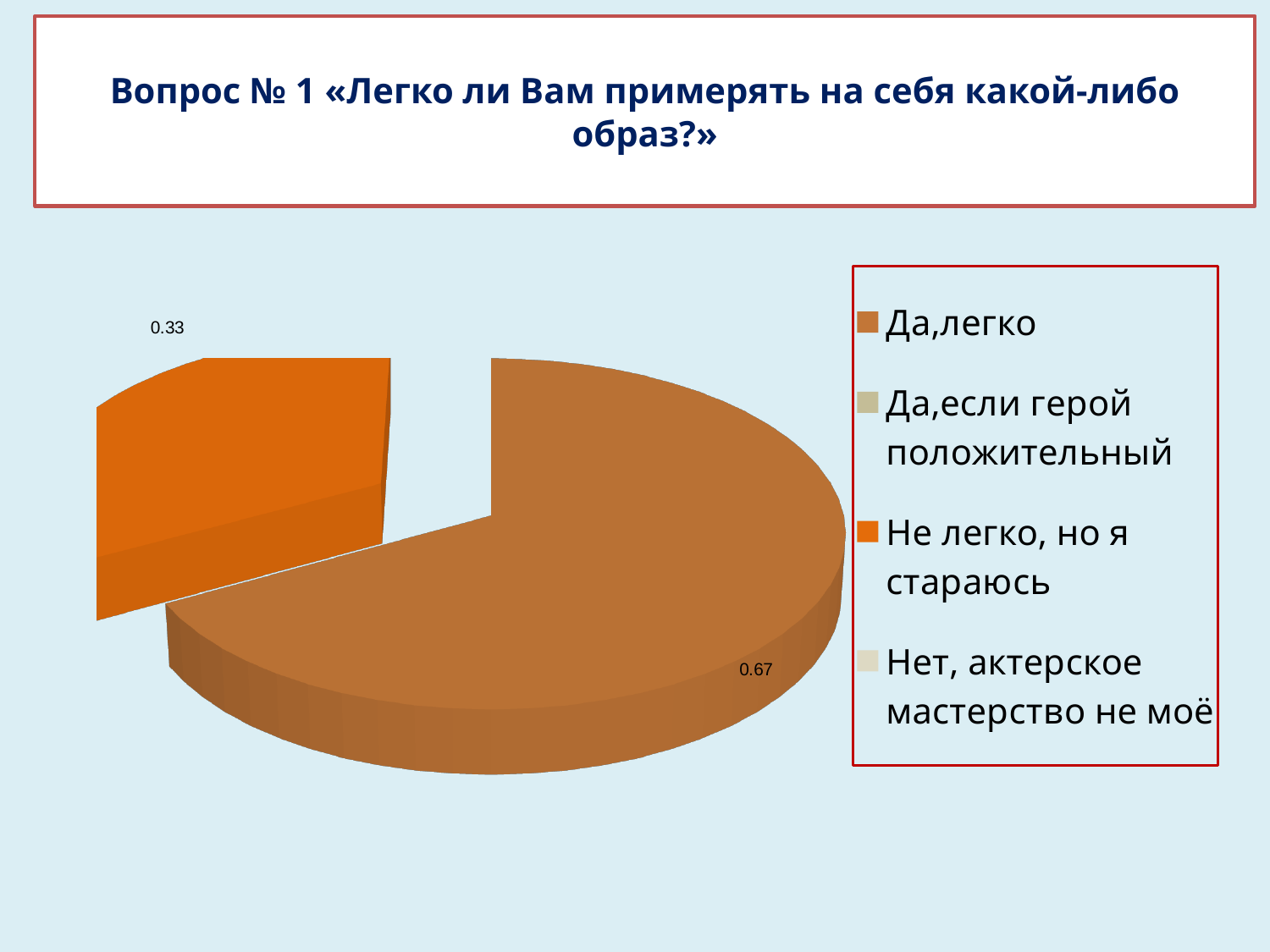
What is the difference between the values for "Да,легко" and "Не легко, но я стараюсь"? 0.34 Which of the two labelled slices is smaller? Не легко, но я стараюсь What is the title of the slide containing the chart? Вопрос № 1 «Легко ли Вам примерять на себя какой-либо образ?» How many entries does the legend list? 4 How many slices with data labels are visible in the pie? 2 Which category has the largest slice of the pie? Да,легко What is the value for "Не легко, но я стараюсь"? 0.33 What kind of chart is shown on the slide? pie chart What is the value for "Да,легко"? 0.67 What colour is the slice for "Не легко, но я стараюсь"? orange Which is larger: the value for "Да,легко" or the value for "Не легко, но я стараюсь"? Да,легко